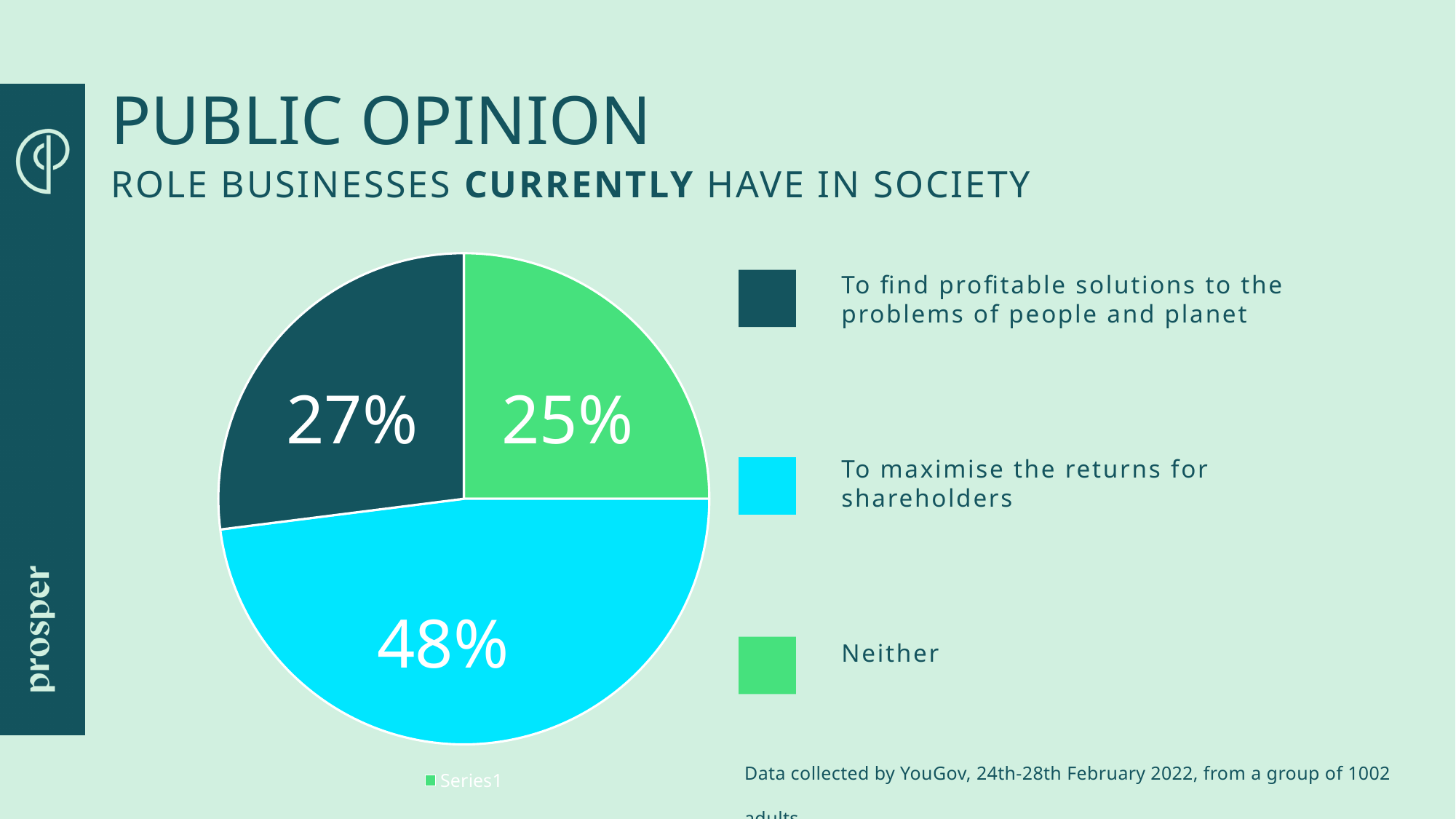
What series name is shown in the legend below the pie chart? Series1 What is the difference in percentage points between 'To maximise the returns for shareholders' and 'Neither'? 23 What kind of chart is shown on the slide? Pie chart Which is larger: the share for 'To maximise the returns for shareholders' or the share for 'To find profitable solutions to the problems of people and planet'? To maximise the returns for shareholders What percentage of respondents said the role of businesses is to find profitable solutions to the problems of people and planet? 27% How many slices does the pie chart have? 3 Which response has the largest share of the pie? To maximise the returns for shareholders What is the difference in percentage points between 'To find profitable solutions to the problems of people and planet' and 'Neither'? 2 Which response has the smallest share of the pie? Neither What percentage of respondents said the role of businesses is to maximise the returns for shareholders? 48% What colour is the slice representing 'To maximise the returns for shareholders'? Cyan What percentage of respondents answered 'Neither'? 25%